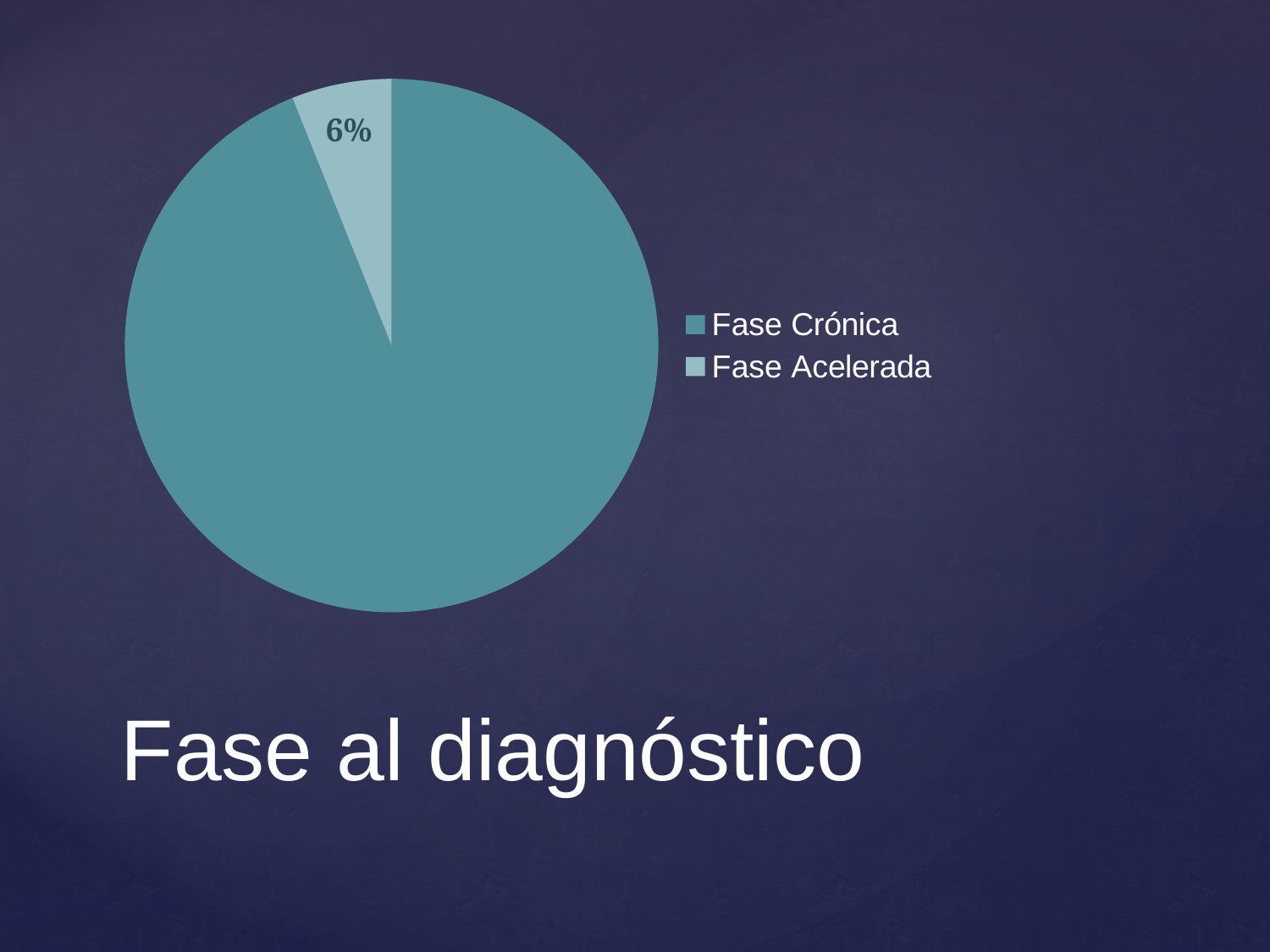
How many entries does the legend of the pie chart list? 2 What is the title text shown below the pie chart on the slide? Fase al diagnóstico Which category has the largest slice in the pie chart? Fase Crónica What kind of chart is shown on the slide? Pie chart Which slice is larger, Fase Crónica or Fase Acelerada? Fase Crónica Which category has the smallest slice in the pie chart? Fase Acelerada Which legend entry is listed first in the pie chart's legend? Fase Crónica What percentage does the Fase Acelerada slice show in the pie chart? 6% How many categories are shown in the pie chart? 2 What share of the pie does the Fase Acelerada slice represent? 6%